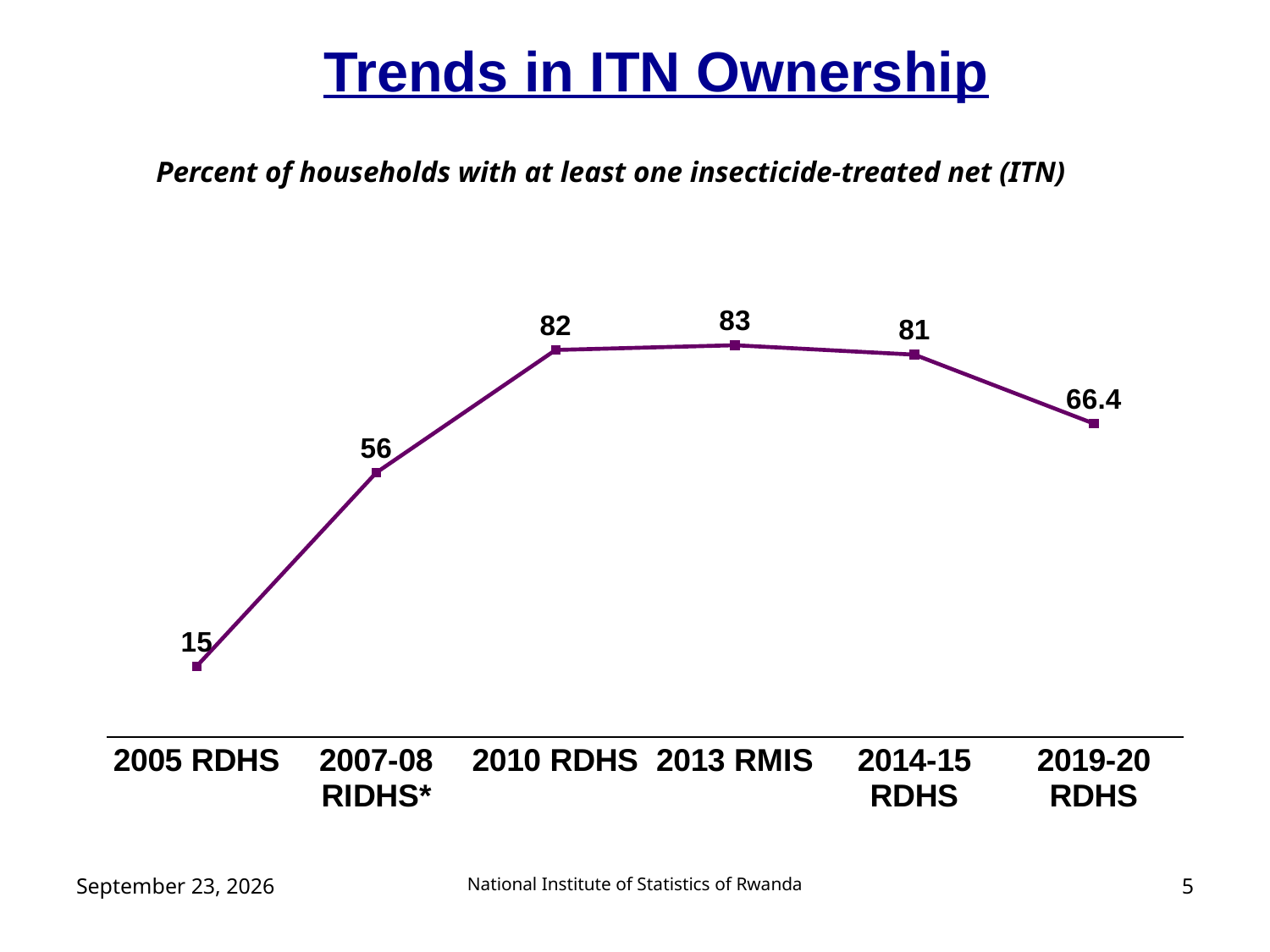
Which survey has the lowest percent of households with at least one ITN? 2005 RDHS Does the value rise or fall from 2014-15 RDHS to 2019-20 RDHS? Fall What value is shown for the 2007-08 RIDHS*? 56 What is the title of the chart on the slide? Trends in ITN Ownership How many survey points are plotted on the chart? 6 What value is shown for the 2019-20 RDHS? 66.4 Which survey has the highest percent of households with at least one ITN? 2013 RMIS What is the difference between the 2010 RDHS value and the 2005 RDHS value? 67 What is the percent of households with at least one ITN in the 2005 RDHS? 15 What is the difference between the 2014-15 RDHS value and the 2019-20 RDHS value? 14.6 Which is larger, the value for 2010 RDHS or the value for 2007-08 RIDHS*? 2010 RDHS What kind of chart is shown on the slide? Line chart